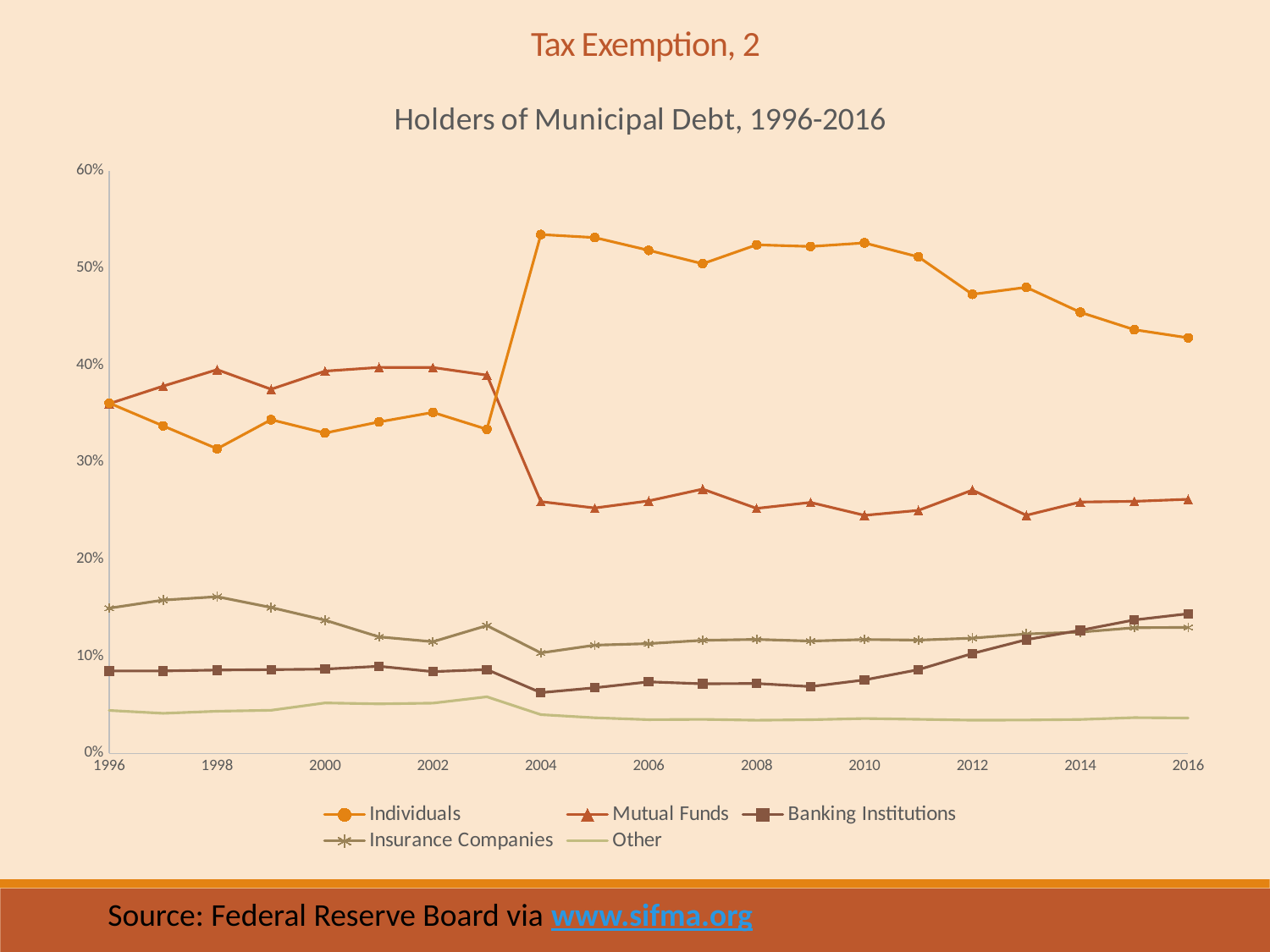
Is the value for Individuals in 2004 greater or less than 50%? greater Which series is plotted with triangle markers? Mutual Funds Does the value for Banking Institutions rise or fall from 2009 to 2016? rise Which is larger in 2000, the value for Individuals or the value for Mutual Funds? Mutual Funds Which series has the lowest value in 2016? Other What is the title of the chart? Holders of Municipal Debt, 1996-2016 Is the value for Individuals in 1998 greater or less than 40%? less What kind of chart is shown on the slide? line chart Which series has the highest value in 2016? Individuals How many series does the legend list? 5 Is the value for Mutual Funds in 2016 greater or less than 30%? less Does the value for Individuals rise or fall from 2010 to 2016? fall